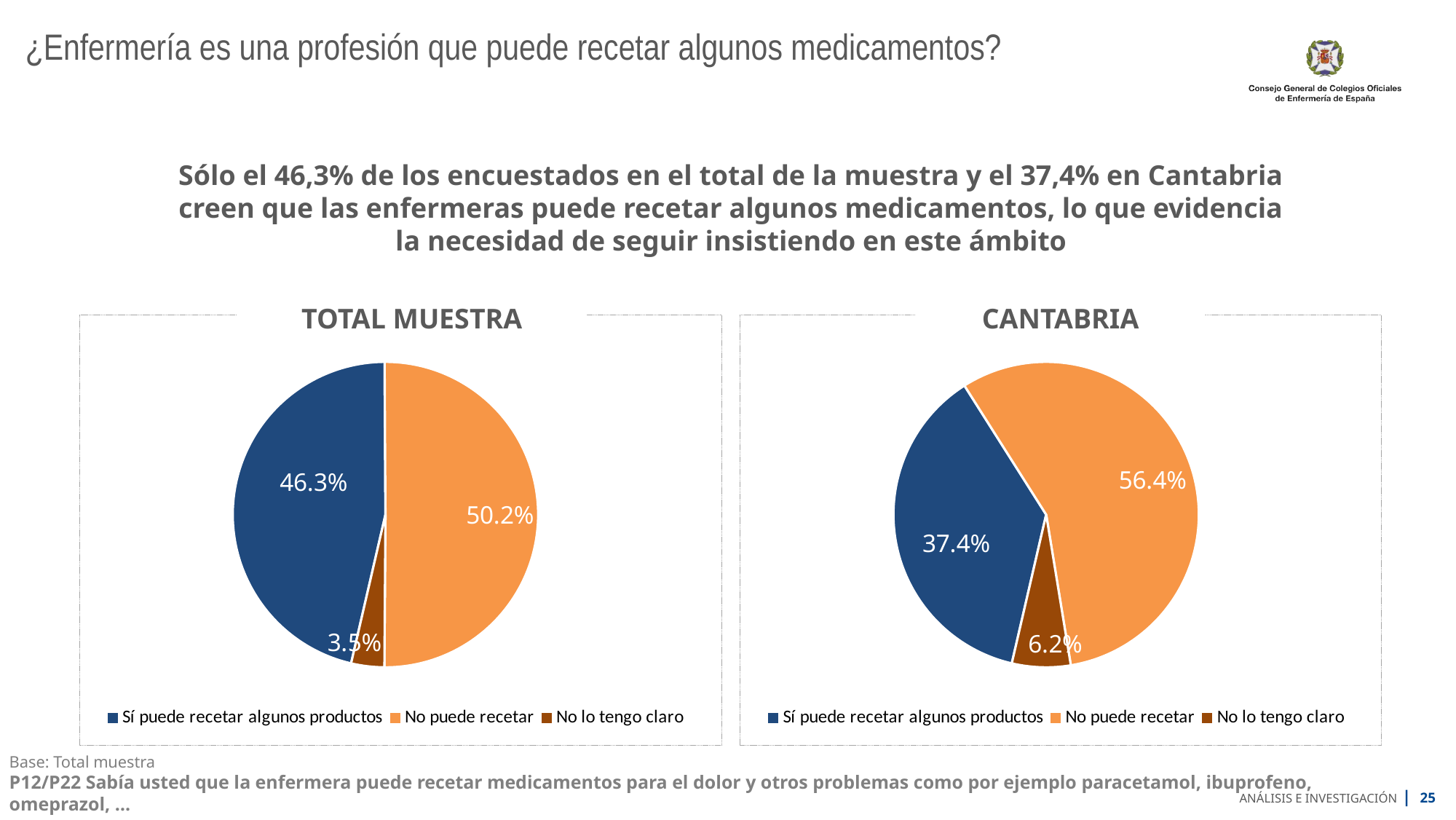
Which is larger: 'No lo tengo claro' in the TOTAL MUESTRA chart or in the CANTABRIA chart? CANTABRIA In the CANTABRIA chart, what is the difference between 'No puede recetar' and 'Sí puede recetar algunos productos'? 19.0% In the TOTAL MUESTRA chart, which category has the smallest share? No lo tengo claro In the TOTAL MUESTRA chart, what percentage corresponds to 'No lo tengo claro'? 3.5% What type of chart is the TOTAL MUESTRA chart? Pie chart How many categories does the legend of the CANTABRIA chart list? 3 In the CANTABRIA chart, what percentage corresponds to 'No puede recetar'? 56.4% In the CANTABRIA chart, what percentage corresponds to 'Sí puede recetar algunos productos'? 37.4% In the TOTAL MUESTRA chart, what percentage corresponds to 'No puede recetar'? 50.2% In the CANTABRIA chart, which category has the largest share? No puede recetar In the TOTAL MUESTRA chart, what percentage corresponds to 'Sí puede recetar algunos productos'? 46.3% In the CANTABRIA chart, what percentage corresponds to 'No lo tengo claro'? 6.2%